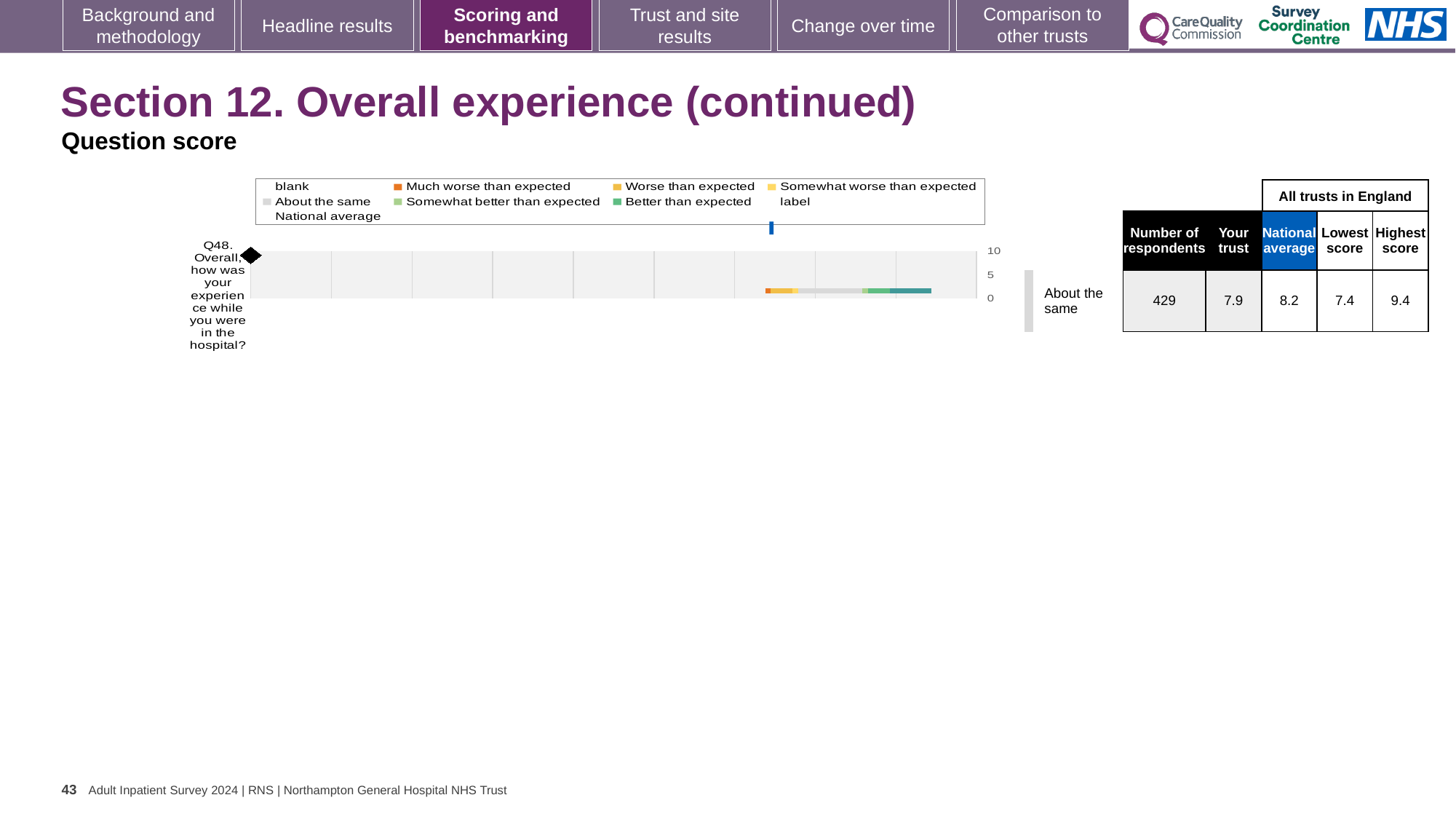
What is the 'Your trust' score for Q48, 'Overall, how was your experience while you were in the hospital?' 7.9 Is the trust's score for Q48 greater or less than 5 on the chart axis? greater How many survey questions are plotted in the chart? 1 How many respondents answered Q48? 429 Which is larger for Q48: the trust's score or the national average? National average By how much does the national average exceed the trust's score for Q48? 0.3 What is the difference between the highest and lowest scores for Q48 across all trusts in England? 2.0 What is the lowest score among all trusts in England for Q48? 7.4 What is the national average score for Q48? 8.2 What kind of chart is used to show the Q48 results? bar chart Which benchmarking category is the trust's Q48 result placed in? About the same What is the highest score among all trusts in England for Q48? 9.4